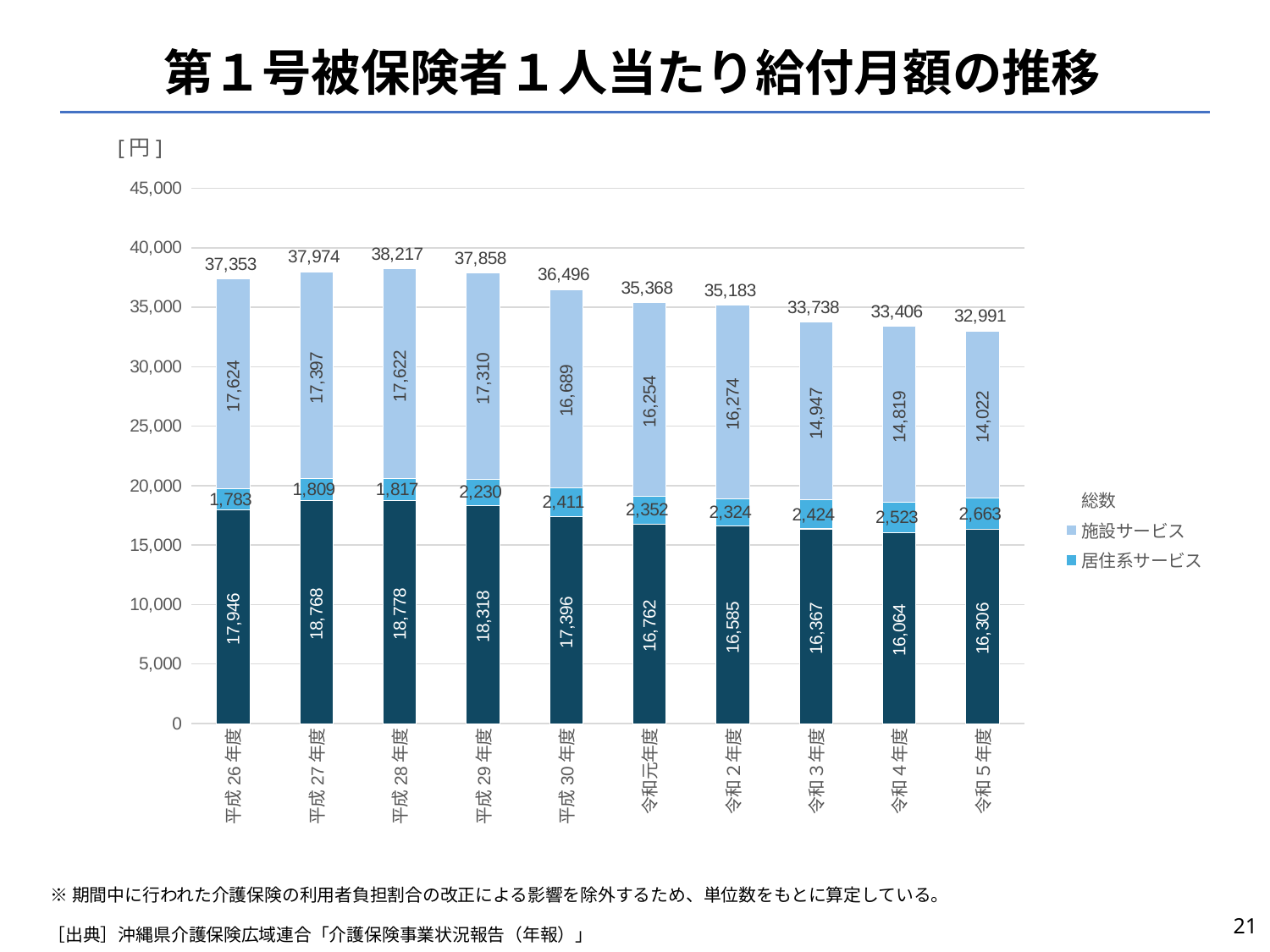
Do the total values rise or fall from 平成28年度 to 令和5年度? Fall What is the difference between the total for 平成26年度 and the total for 令和5年度? 4,362 What kind of chart is shown on the slide? Stacked bar chart What is the total of the stacked bar for 令和3年度? 33,738 Which fiscal year has the lowest total (総数) value? 令和5年度 How many fiscal years are shown on the x axis? 10 What is the value of 施設サービス for 平成28年度? 17,622 What unit is shown at the top left of the chart? 円 What is the value of 居住系サービス for 令和5年度? 2,663 Which fiscal year has the highest total (総数) value? 平成28年度 Which is larger, the 施設サービス value for 平成27年度 or for 平成29年度? 平成27年度 Is the total for 平成30年度 greater or less than 35,000? greater